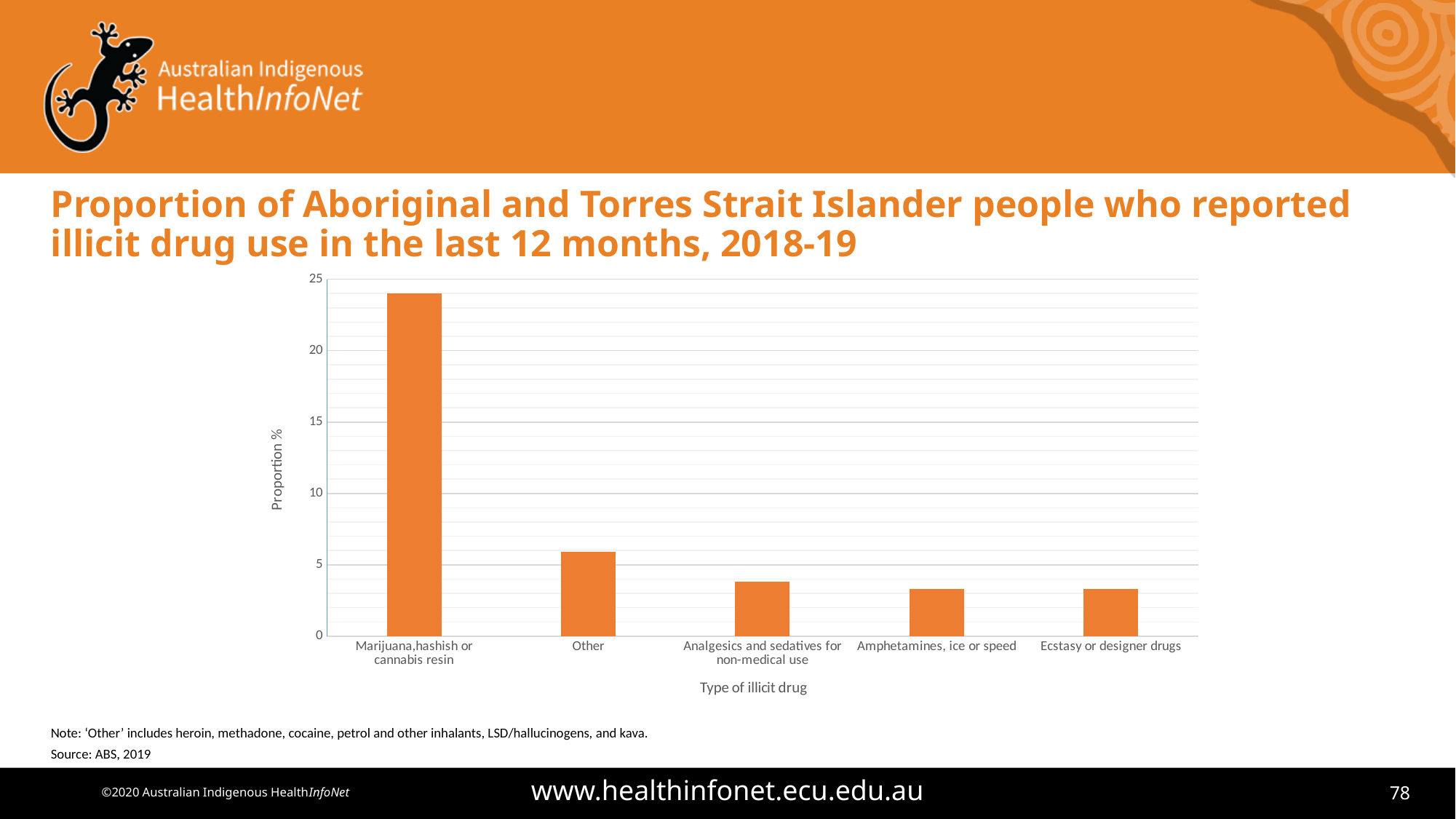
What type of chart is shown on the slide? bar chart How many types of illicit drug are shown on the x axis of the chart? 5 Is the value for Marijuana, hashish or cannabis resin greater or less than 25? less What is the label on the y axis of the chart? Proportion % Is the value for Other greater or less than 5? greater What is the label on the x axis of the chart? Type of illicit drug Is the value for Analgesics and sedatives for non-medical use greater or less than 5? less Which type of illicit drug has the highest reported proportion of use? Marijuana, hashish or cannabis resin Which is larger, the value for Other or the value for Analgesics and sedatives for non-medical use? Other